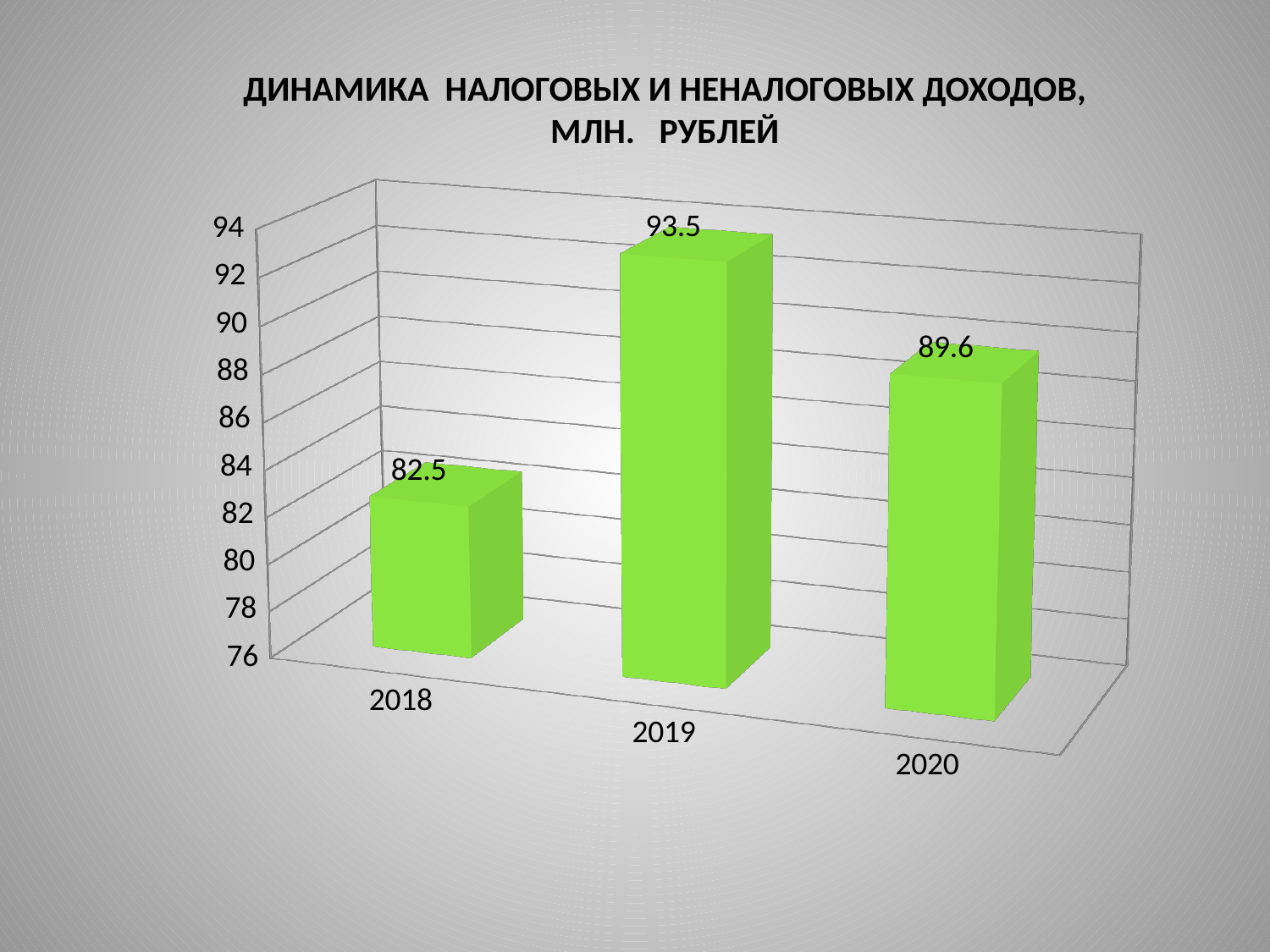
Which year has the highest value? 2019 What is the difference between the values for 2019 and 2020? 3.9 What is the title of the chart? ДИНАМИКА НАЛОГОВЫХ И НЕНАЛОГОВЫХ ДОХОДОВ, МЛН. РУБЛЕЙ What is the difference between the values for 2019 and 2018? 11 What is the value for 2018? 82.5 What kind of chart is shown on the slide? bar chart What is the value for 2019? 93.5 Which year has the lowest value? 2018 Which is larger, the value for 2020 or the value for 2018? 2020 How many years are shown on the chart? 3 What is the value for 2020? 89.6 Is the value for 2020 greater or less than 86? greater